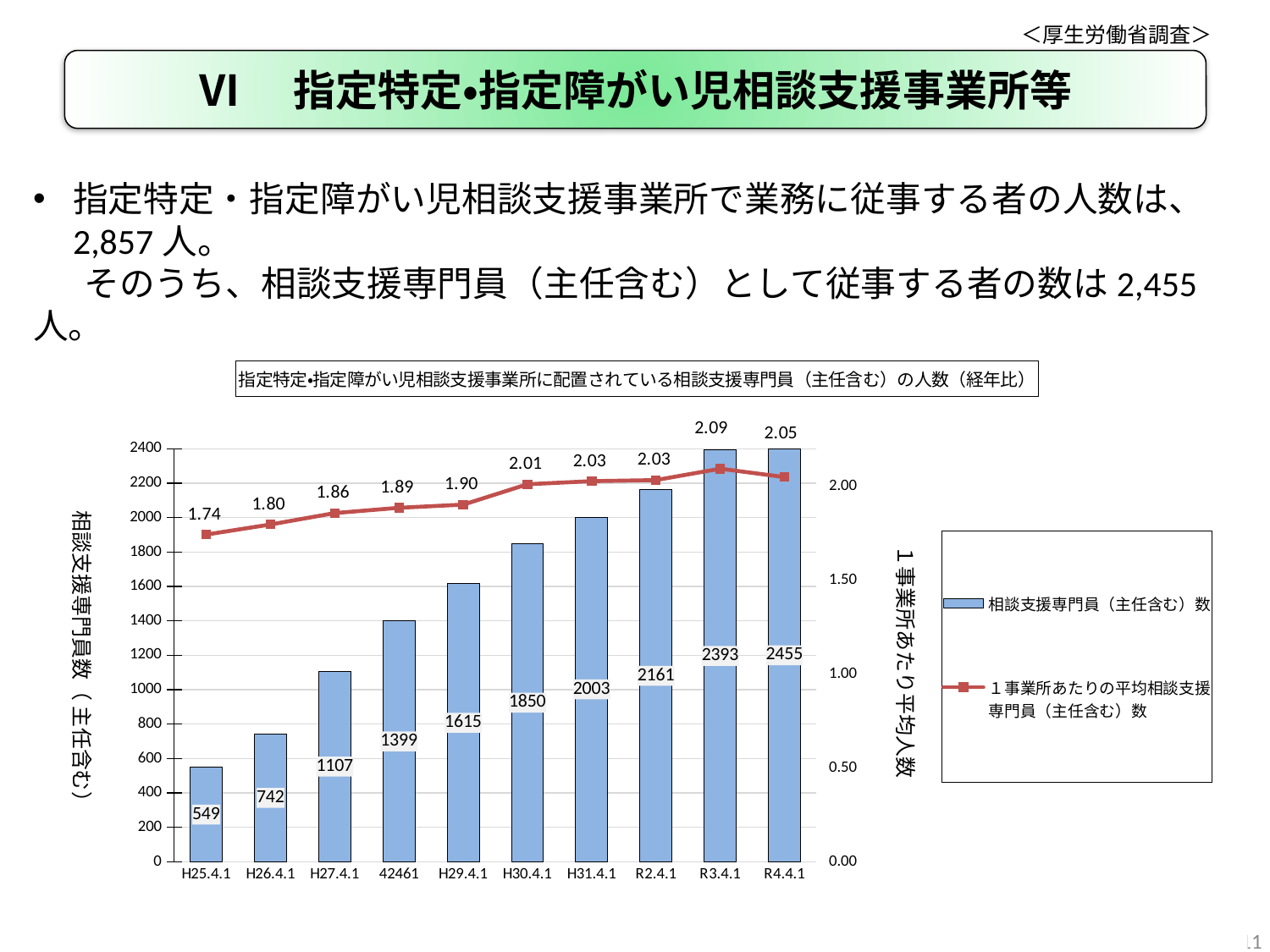
Which category has the highest value of １事業所あたりの平均相談支援専門員（主任含む）数? R3.4.1 How many series does the legend list? 2 Which category has the lowest value of 相談支援専門員（主任含む）数? H25.4.1 Do the values of 相談支援専門員（主任含む）数 rise or fall from H25.4.1 to R4.4.1? rise What kind of chart is shown on the slide? Combined bar and line chart What is the value of 相談支援専門員（主任含む）数 for H25.4.1? 549 What is the difference in 相談支援専門員（主任含む）数 between R4.4.1 and R3.4.1? 62 Is the value of 相談支援専門員（主任含む）数 for H27.4.1 greater or less than 1000? greater Which is larger, the 相談支援専門員（主任含む）数 for H29.4.1 or for H30.4.1? H30.4.1 How many categories are shown on the x axis? 10 What is the value of 相談支援専門員（主任含む）数 for R4.4.1? 2455 What is the value of １事業所あたりの平均相談支援専門員（主任含む）数 for H30.4.1? 2.01